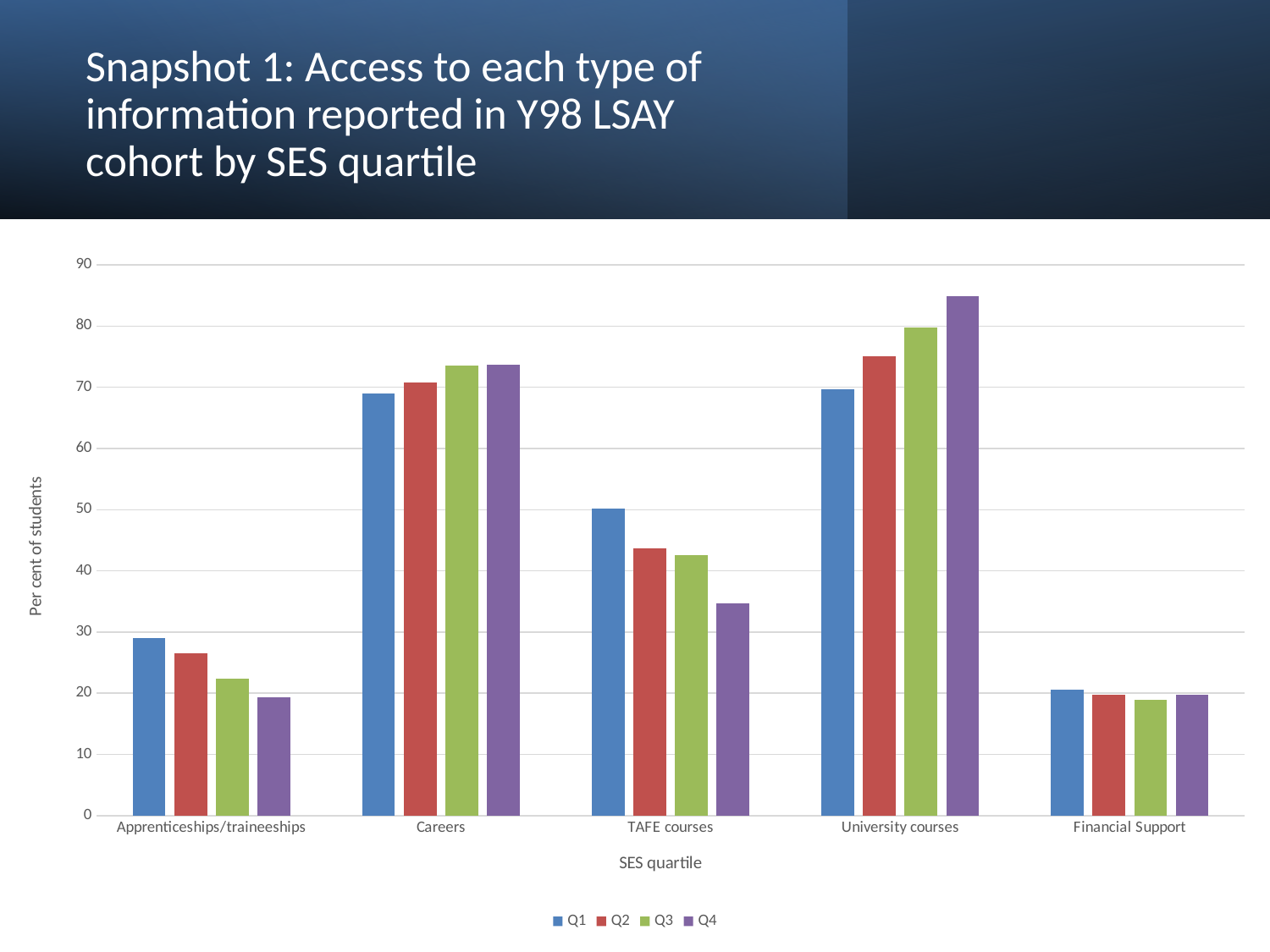
For University courses, do the bars rise or fall from Q1 to Q4? rise How many series does the legend list? 4 What kind of chart is shown on the slide? bar chart Is the Q4 value for University courses greater or less than 80? greater For Apprenticeships/traineeships, which is larger: the Q1 bar or the Q4 bar? Q1 Is the Q4 value for TAFE courses greater or less than 40? less Which category has the highest Q4 bar? University courses Is the Q1 value for TAFE courses greater or less than 40? greater Which category has the lowest Q1 bar? Financial Support What is the title of the vertical axis? Per cent of students Which is larger: the Q4 bar for University courses or the Q4 bar for Careers? University courses How many information-type categories are shown on the x axis? 5